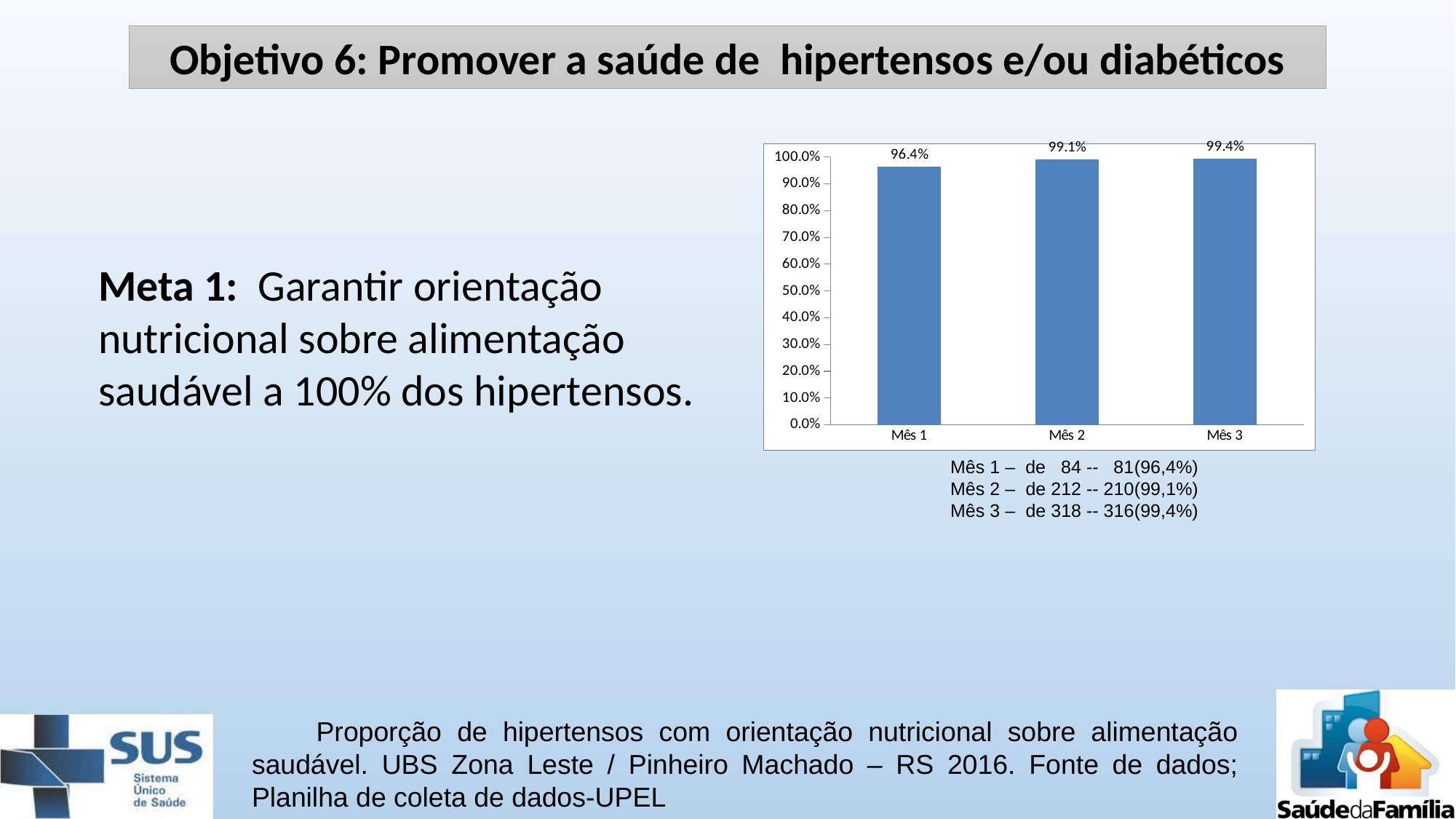
Which month has the lowest value? Mês 1 Is the value for Mês 1 greater or less than 90.0%? greater What is the difference between the values for Mês 3 and Mês 1? 3.0% Do the values rise or fall from Mês 1 to Mês 3? rise What is the value for Mês 3? 99.4% What is the difference between the values for Mês 2 and Mês 1? 2.7% What is the value for Mês 2? 99.1% How many categories are shown on the x axis? 3 What is the highest tick value shown on the y axis? 100.0% Which is larger, the value for Mês 1 or the value for Mês 2? Mês 2 What is the value for Mês 1? 96.4% What kind of chart is shown on the slide? bar chart